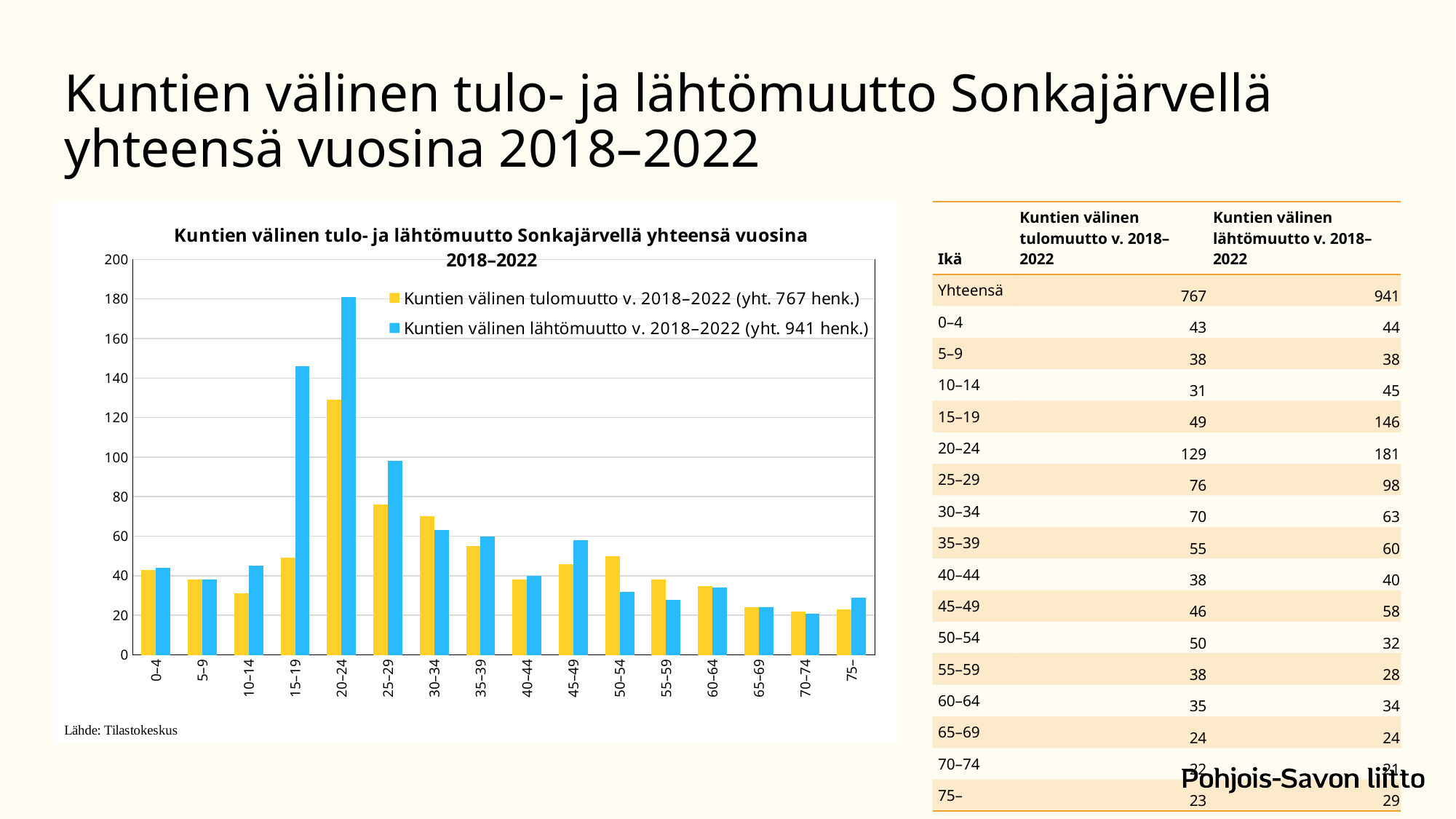
Which age group has the highest value for Kuntien välinen tulomuutto v. 2018–2022? 20–24 What is the value of Kuntien välinen lähtömuutto v. 2018–2022 for the 15–19 age group? 146 How many series does the chart's legend list? 2 Which age group has the highest value for Kuntien välinen lähtömuutto v. 2018–2022? 20–24 According to the legend, what is the total number of persons for Kuntien välinen tulomuutto v. 2018–2022? 767 henk. For the 50–54 age group, which is larger: tulomuutto or lähtömuutto? tulomuutto Is the value of lähtömuutto for the 25–29 age group greater or less than 100? less For the 20–24 age group, what is the difference between lähtömuutto and tulomuutto? 52 What is the value of Kuntien välinen tulomuutto v. 2018–2022 for the 20–24 age group? 129 What kind of chart is shown on the slide? bar chart Do the lähtömuutto values rise or fall from the 20–24 age group to the 30–34 age group? fall How many age groups are shown on the x axis of the chart? 16